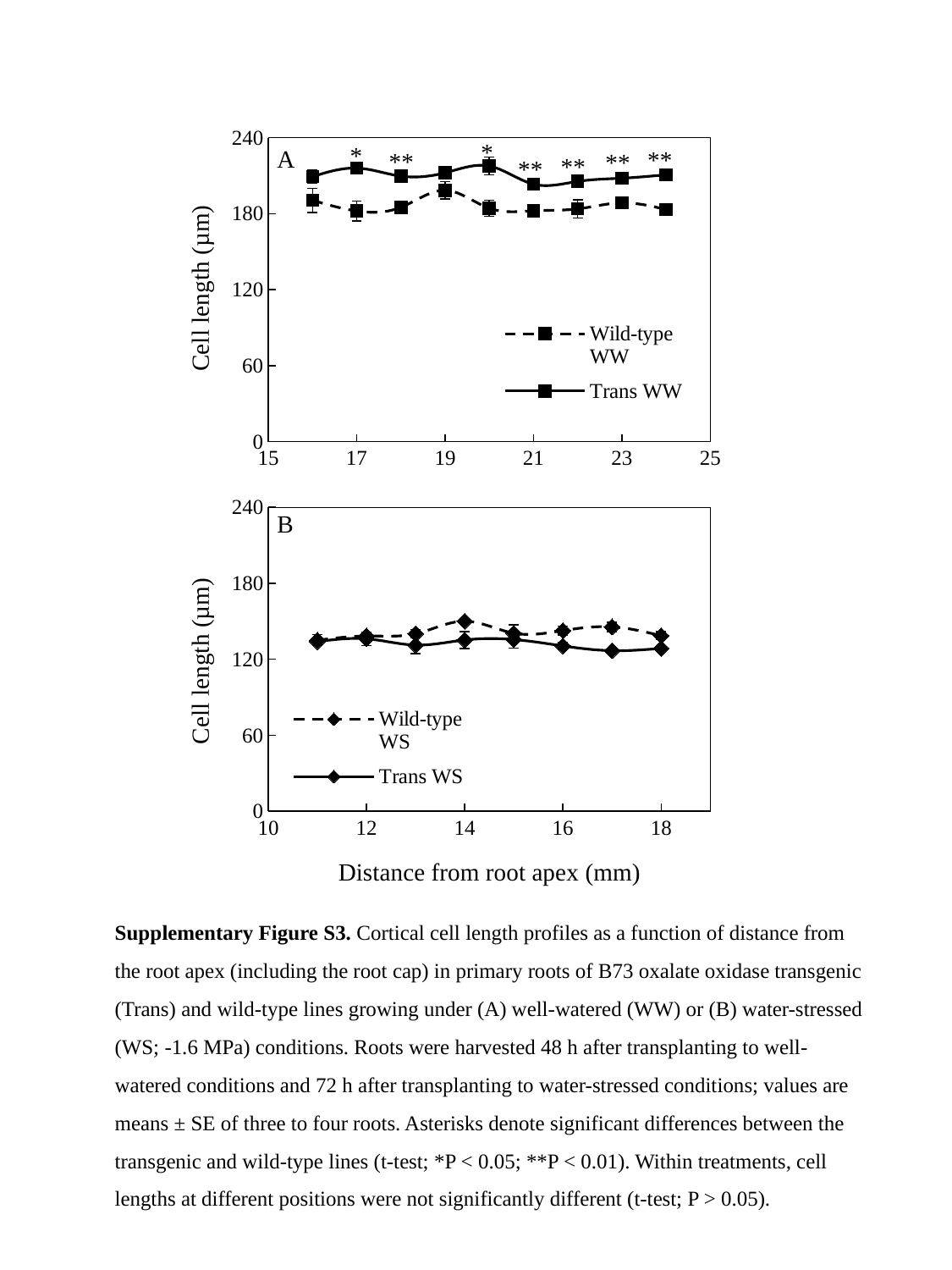
In chart B (the bottom chart), how many data points does the Wild-type WS series have? 8 In chart B (the bottom chart), is the value for Trans WS at 17 mm greater or less than 180? less In chart B (the bottom chart), which series has the larger value at 14 mm, Wild-type WS or Trans WS? Wild-type WS In chart A (the top chart), how many data points does the Trans WW series have? 9 What are the two legend entries in chart A (the top chart)? Wild-type WW and Trans WW In chart B (the bottom chart), is the value for Wild-type WS at 14 mm greater or less than 120? greater What kind of chart is chart A (the top chart)? line chart In chart A (the top chart), is the value for Wild-type WW at 19 mm greater or less than 180? greater What is the y-axis label of chart A (the top chart)? Cell length (µm) In chart A (the top chart), which series has the larger value at 20 mm, Trans WW or Wild-type WW? Trans WW How many series does the legend of chart B (the bottom chart) list? 2